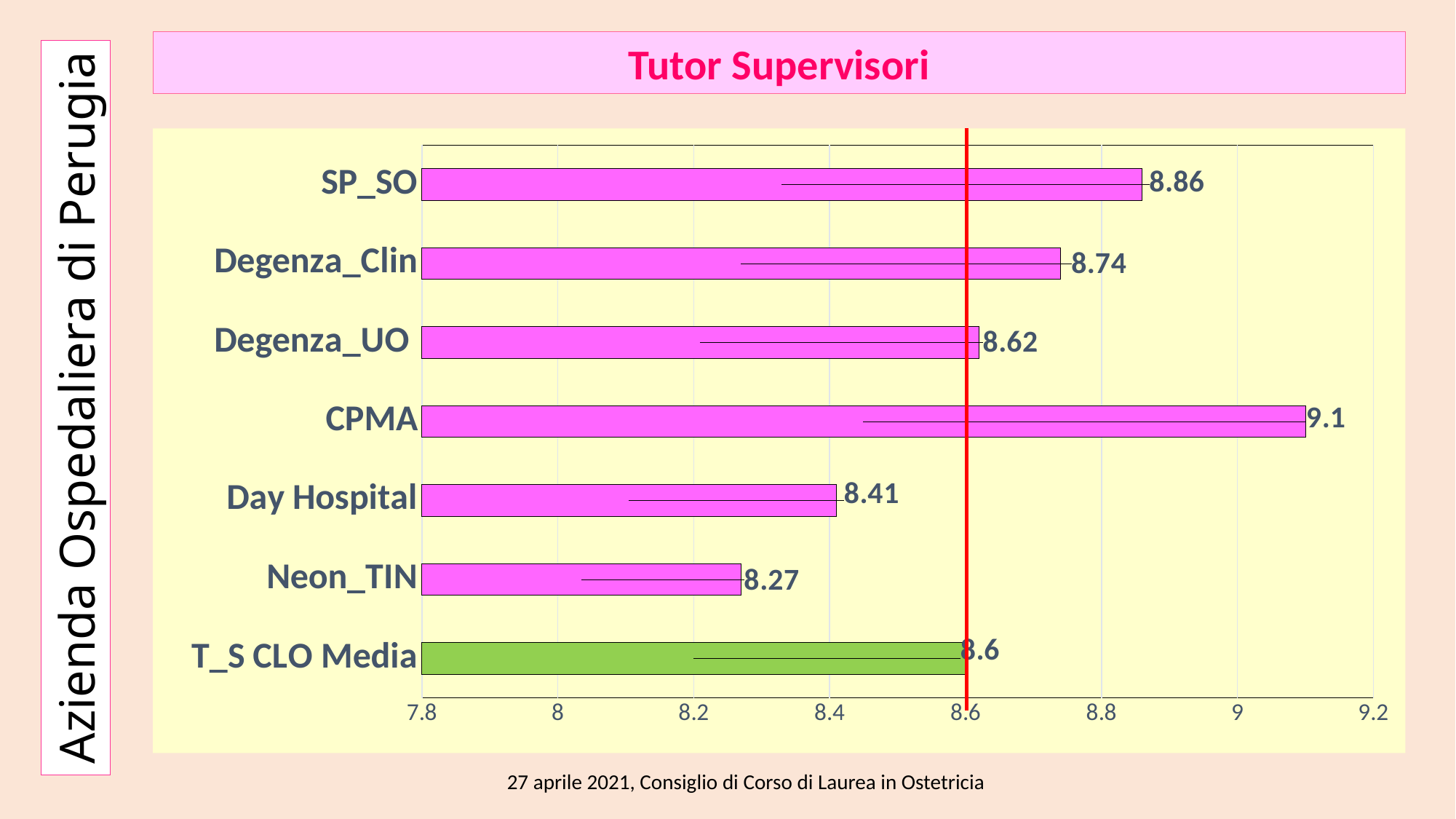
What is the value for SP_SO? 8.86 Is the value for Neon_TIN greater or less than 8.4? less Which category has the lowest value? Neon_TIN Which is larger, the value for Degenza_UO or the value for Day Hospital? Degenza_UO What is the value for Day Hospital? 8.41 What is the difference between the values for SP_SO and Degenza_Clin? 0.12 What is the value for T_S CLO Media? 8.6 What kind of chart is shown on the slide? bar chart How many categories are shown in the chart? 7 What is the difference between the values for CPMA and Neon_TIN? 0.83 Which category has the highest value? CPMA What is the title of the chart? Tutor Supervisori